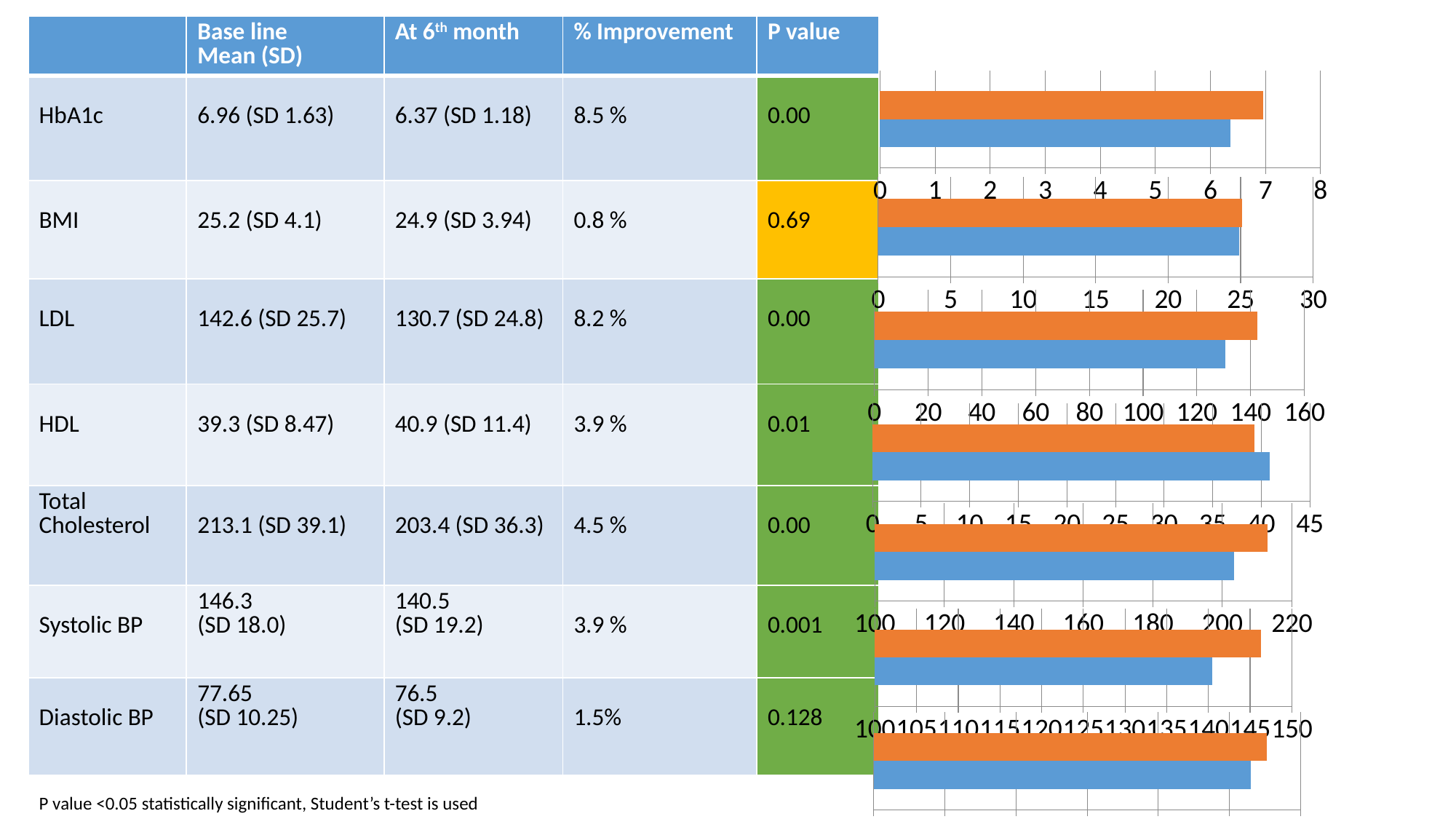
How many bars does the topmost chart (axis 0 to 8) show? 2 In the chart whose axis runs from 0 to 160, which bar is longer, the orange or the blue? orange In the topmost chart (axis 0 to 8), which bar is longer, the orange or the blue? orange In the chart whose axis runs from 0 to 160, is the blue bar greater or less than 140? less In the chart whose axis runs from 100 to 220, which bar is longer, the orange or the blue? orange What kind of chart is the topmost chart on the right of the slide (axis 0 to 8)? bar chart In the chart whose axis runs from 100 to 220, is the orange bar greater or less than 200? greater How many separate bar charts are shown on the right side of the slide? 7 In the chart whose axis runs from 0 to 45, is the orange bar greater or less than 35? greater What two colours are used for the bars in the charts on the right of the slide? orange and blue